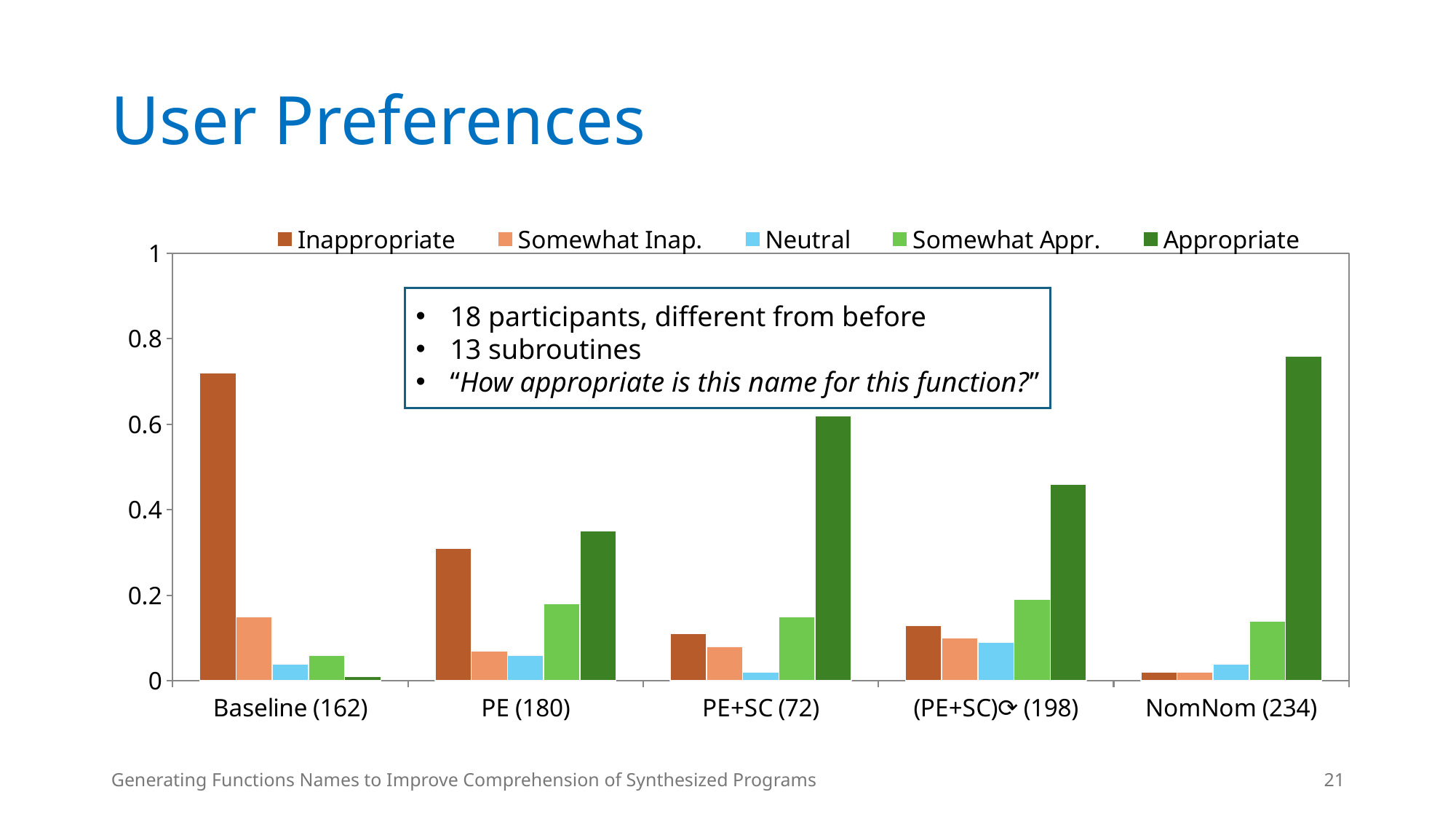
Which category has the highest Appropriate value? NomNom (234) How many series does the legend list? 5 How many categories are shown on the x axis? 5 Is the Appropriate value for NomNom (234) greater or less than 0.6? greater What kind of chart is shown on the slide? bar chart Which category has the lowest Appropriate value? Baseline (162) Which category has the highest Inappropriate value? Baseline (162) Is the Appropriate value for PE (180) greater or less than 0.4? less Is the Appropriate value for PE+SC (72) greater or less than 0.4? greater Which has the larger Appropriate value, PE+SC (72) or (PE+SC)⟳ (198)? PE+SC (72) What is the title of the slide containing the chart? User Preferences